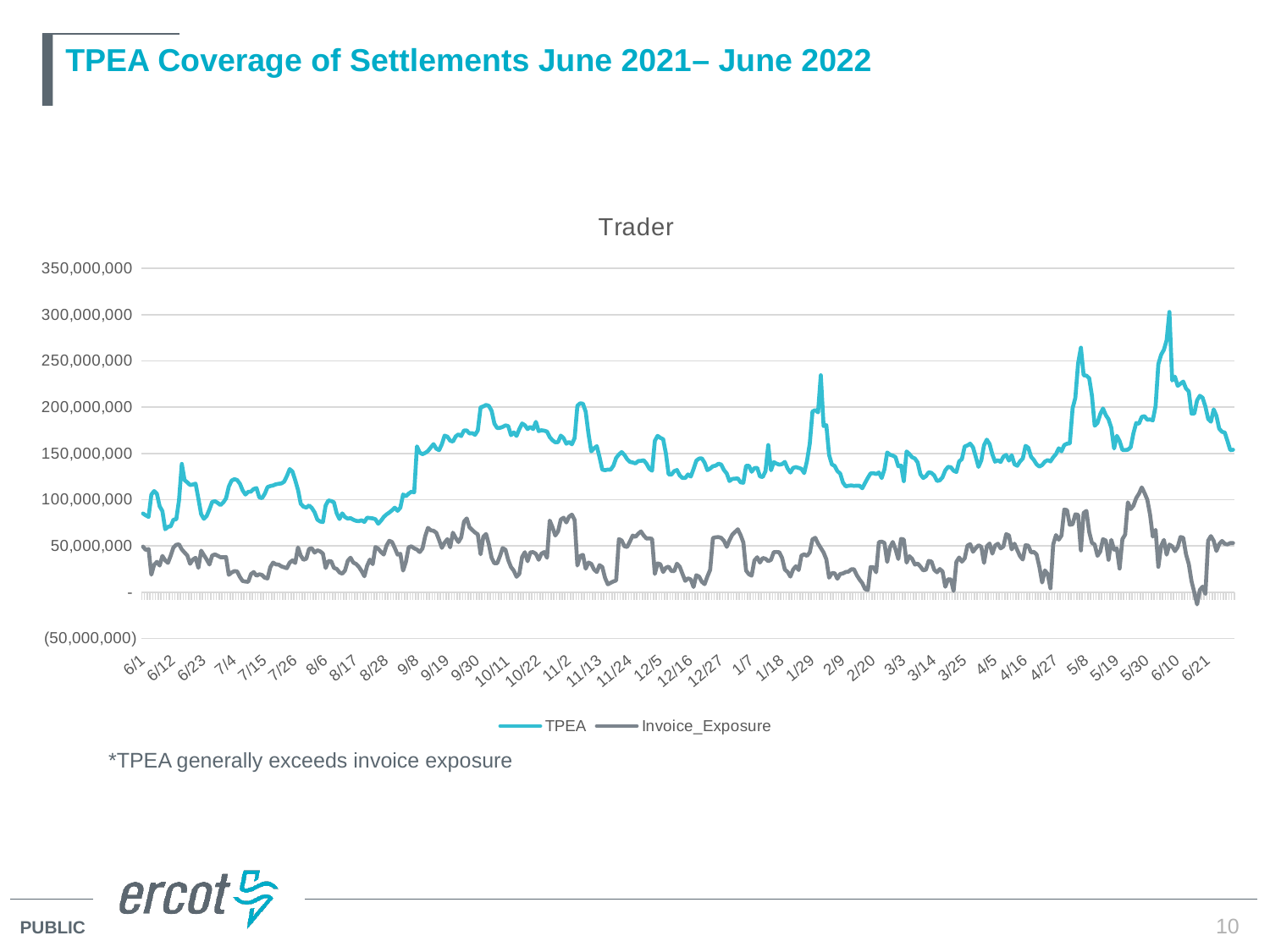
Is the Invoice_Exposure value at 11/2 greater or less than 150,000,000? less What is the title shown above the chart? Trader Is the TPEA value at its peak near 6/10 greater or less than 250,000,000? greater How many series does the legend list? 2 What are the two series named in the legend? TPEA and Invoice_Exposure Is the Invoice_Exposure value at 6/1 greater or less than 100,000,000? less Which series reaches the highest value anywhere on the chart? TPEA Does the TPEA line rise or fall between 9/8 and 9/30? rise What kind of chart is shown on the slide? line chart What is the highest value labelled on the vertical axis? 350,000,000 At 1/29, which series has the higher value, TPEA or Invoice_Exposure? TPEA